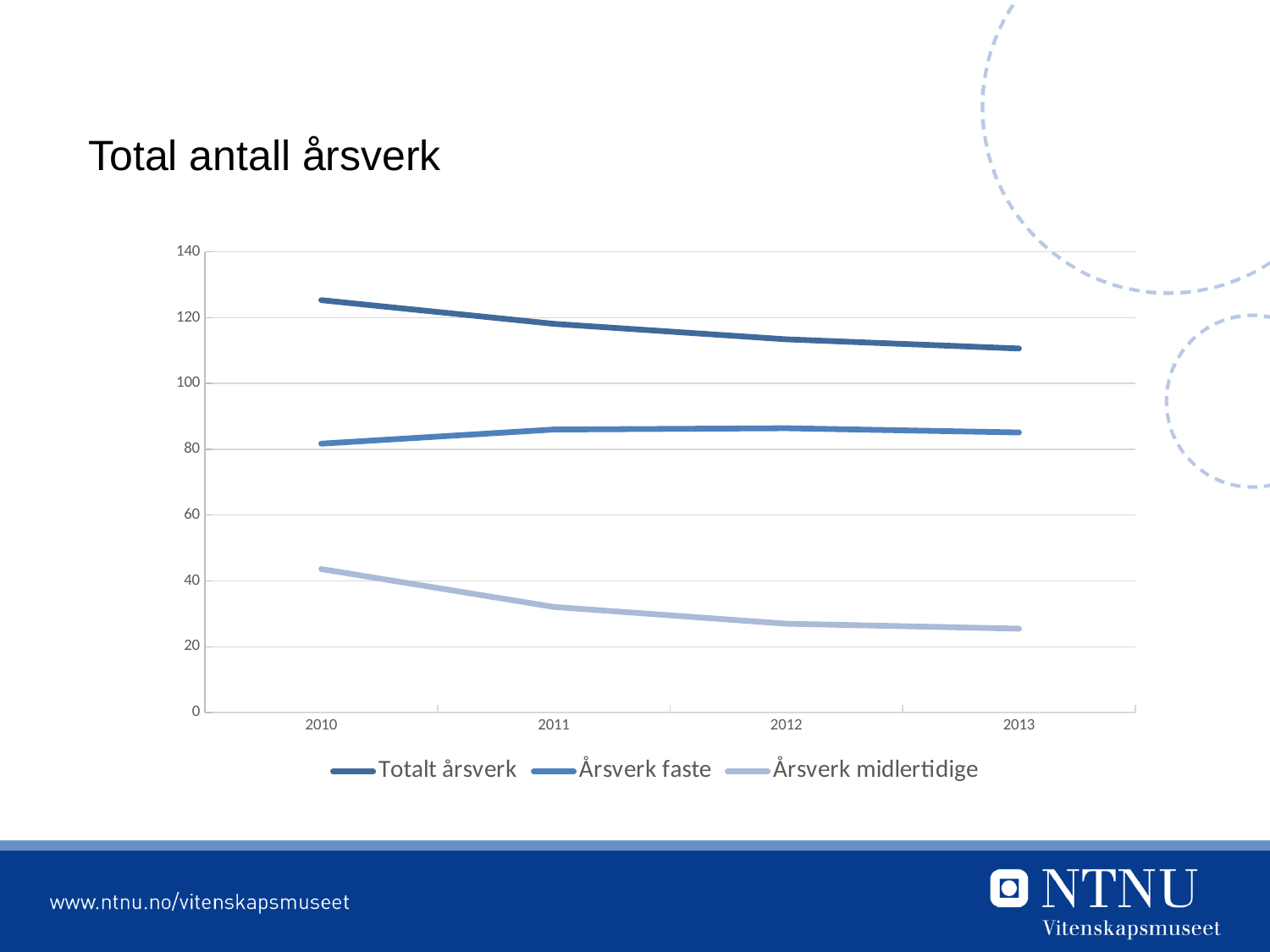
In which year is Årsverk midlertidige lowest? 2013 Which is larger: Årsverk faste in 2013 or Årsverk midlertidige in 2013? Årsverk faste Does the Årsverk midlertidige line rise or fall from 2010 to 2013? fall How many years are shown on the x axis? 4 Is the value for Årsverk faste in 2013 greater or less than 80? greater Does the Totalt årsverk line rise or fall from 2010 to 2013? fall Is the value for Totalt årsverk in 2010 greater or less than 120? greater What kind of chart is shown on the slide? line chart How many series does the legend list? 3 What is the title of the slide above the chart? Total antall årsverk Is the value for Årsverk midlertidige in 2011 greater or less than 40? less In which year is Totalt årsverk highest? 2010